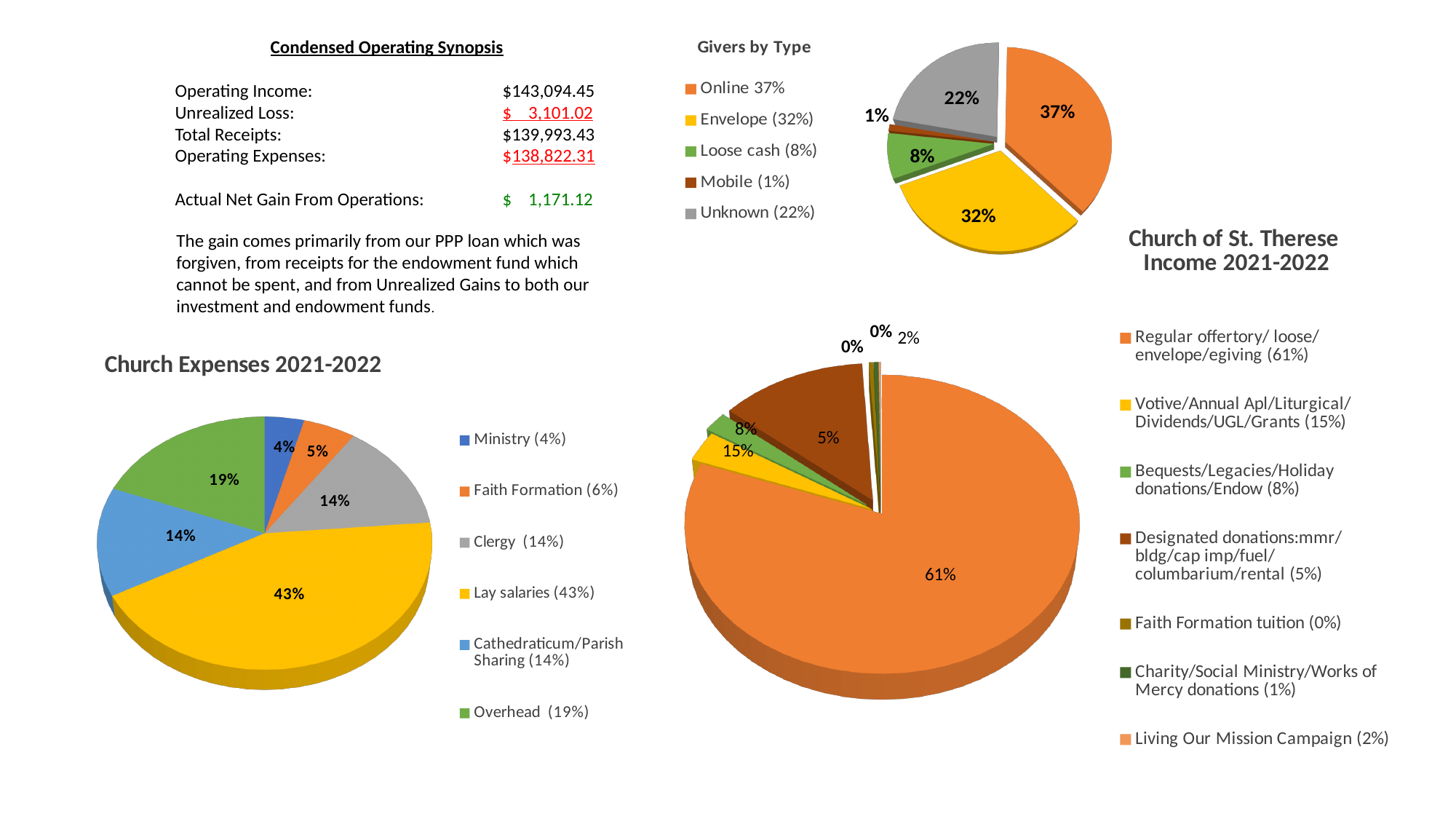
What kind of chart is the Church Expenses 2021-2022 chart? Pie chart In the Church of St. Therese Income 2021-2022 chart, what share is Bequests/Legacies/Holiday donations/Endow? 8% In the Church Expenses 2021-2022 chart, what share of expenses is Ministry? 4% In the Church of St. Therese Income 2021-2022 chart, what share is Regular offertory/ loose/ envelope/egiving? 61% In the Church Expenses 2021-2022 chart, which is larger, Overhead or Clergy? Overhead In the Givers by Type chart, how many giver types are shown in the legend? 5 In the Givers by Type chart, which giver type has the smallest share? Mobile In the Givers by Type chart, what share of givers is Online? 37% In the Church Expenses 2021-2022 chart, what share of expenses is Lay salaries? 43% In the Church Expenses 2021-2022 chart, which category has the largest share? Lay salaries In the Givers by Type chart, what is the difference in percentage points between Envelope and Unknown? 10 In the Church of St. Therese Income 2021-2022 chart, how many categories does the legend list? 7